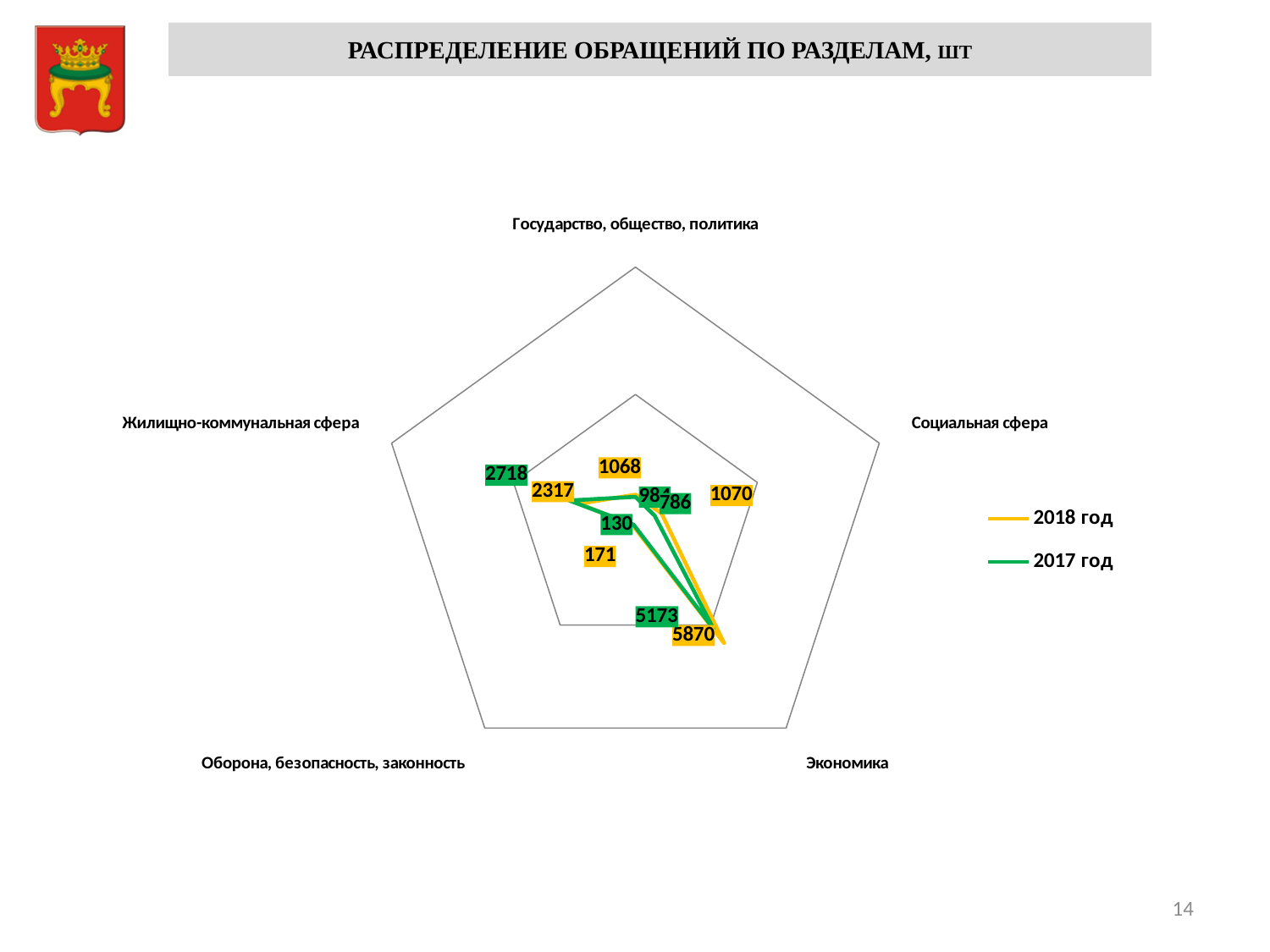
What kind of chart is shown on the slide? radar chart Which category has the highest value in the 2018 год series? Экономика What is the value for Оборона, безопасность, законность in the 2017 год series? 130 What is the value for Жилищно-коммунальная сфера in the 2017 год series? 2718 What is the value for Экономика in the 2017 год series? 5173 What is the difference between the 2018 год and 2017 год values for Экономика? 697 What is the value for Экономика in the 2018 год series? 5870 For Жилищно-коммунальная сфера, which series has the larger value, 2018 год or 2017 год? 2017 год How many series does the legend list? 2 How many categories (axes) does the radar chart have? 5 What is the value for Социальная сфера in the 2018 год series? 1070 Which category has the lowest value in the 2017 год series? Оборона, безопасность, законность